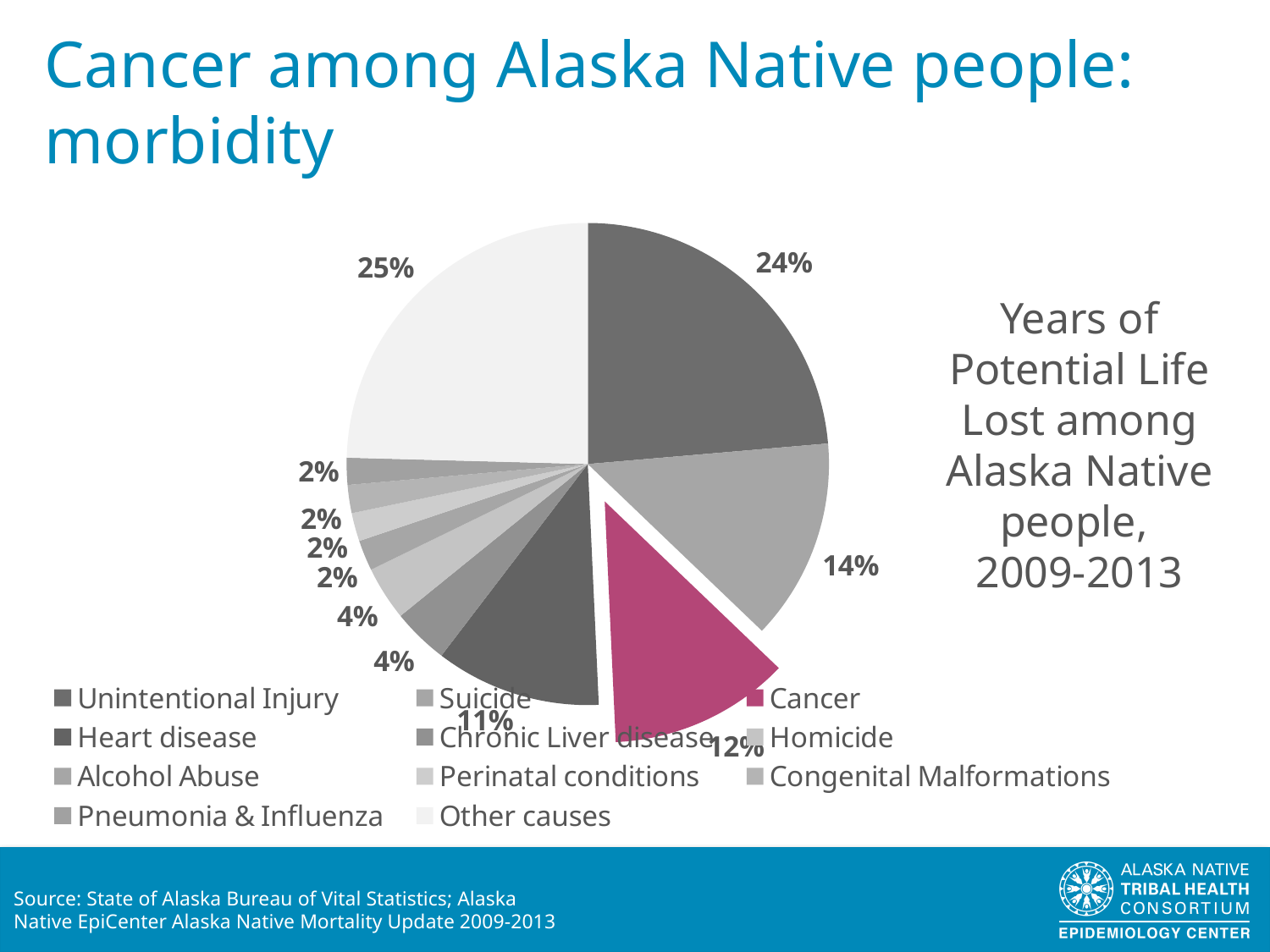
What kind of chart is shown on the slide? Pie chart Which category is shown as the highlighted magenta slice pulled out from the pie? Cancer Which has a larger share, Cancer or Suicide? Suicide What percentage of the pie is labelled for Cancer? 12% What percentage is shown for Heart disease? 11% What percentage is shown for Unintentional Injury? 24% How many categories does the legend list? 11 Which category has the largest share of the pie? Other causes What is the difference in percentage points between Other causes and Cancer? 13 percentage points What percentage is shown for Other causes? 25% What time period does the chart's caption say the Years of Potential Life Lost data covers? 2009-2013 What percentage is shown for Suicide? 14%